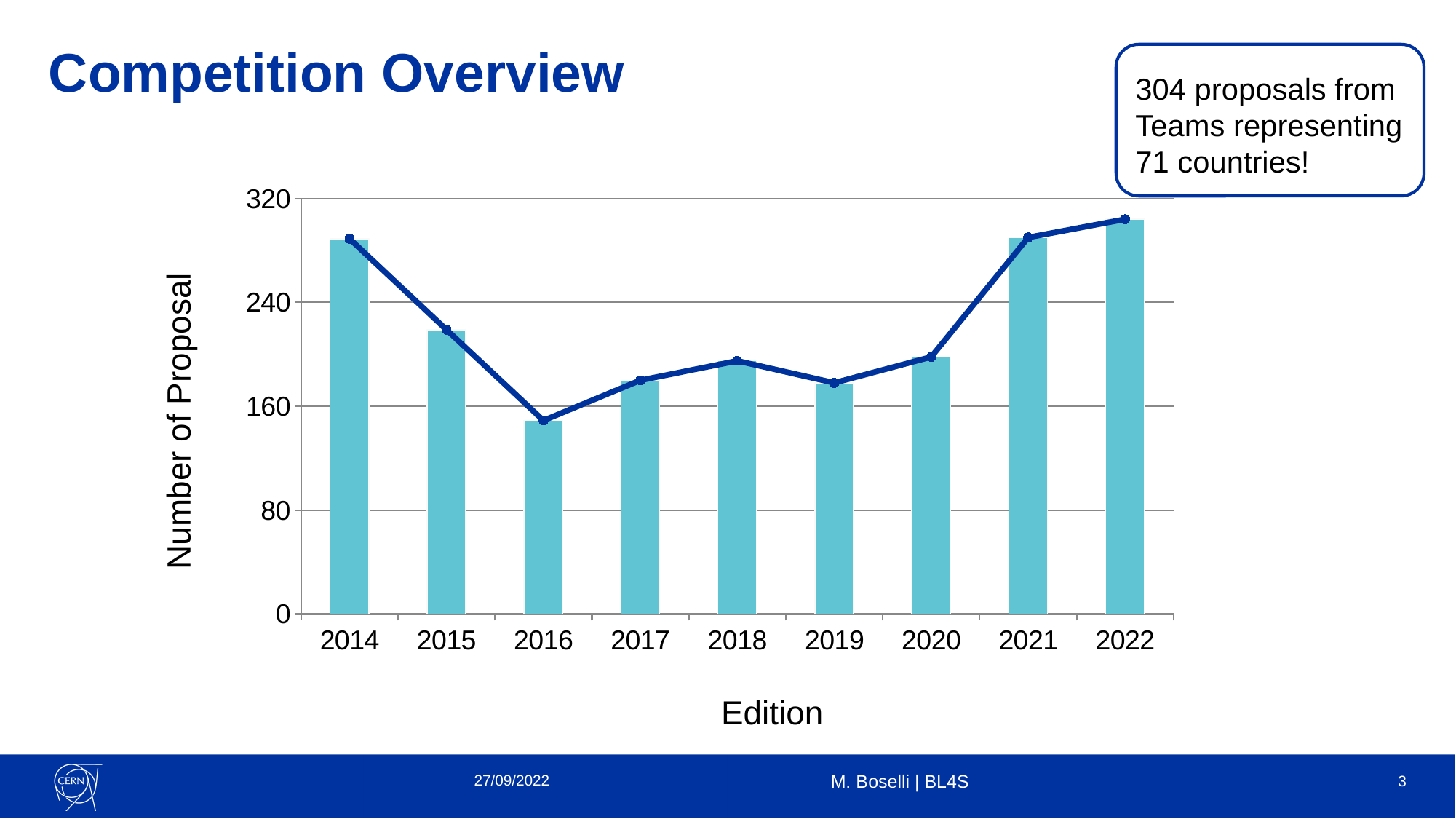
Which edition has the highest number of proposals? 2022 What kind of chart is shown on the slide? combination bar and line chart Which edition has the lowest number of proposals? 2016 What is the title of the y axis of the chart? Number of Proposal Is the value for 2015 greater or less than 240? less How many editions are shown on the x axis of the chart? 9 Which edition has more proposals, 2014 or 2015? 2014 Is the value for 2016 greater or less than 160? less Do the values rise or fall from 2019 to 2022? rise Is the value for 2014 greater or less than 240? greater Which edition has more proposals, 2017 or 2020? 2020